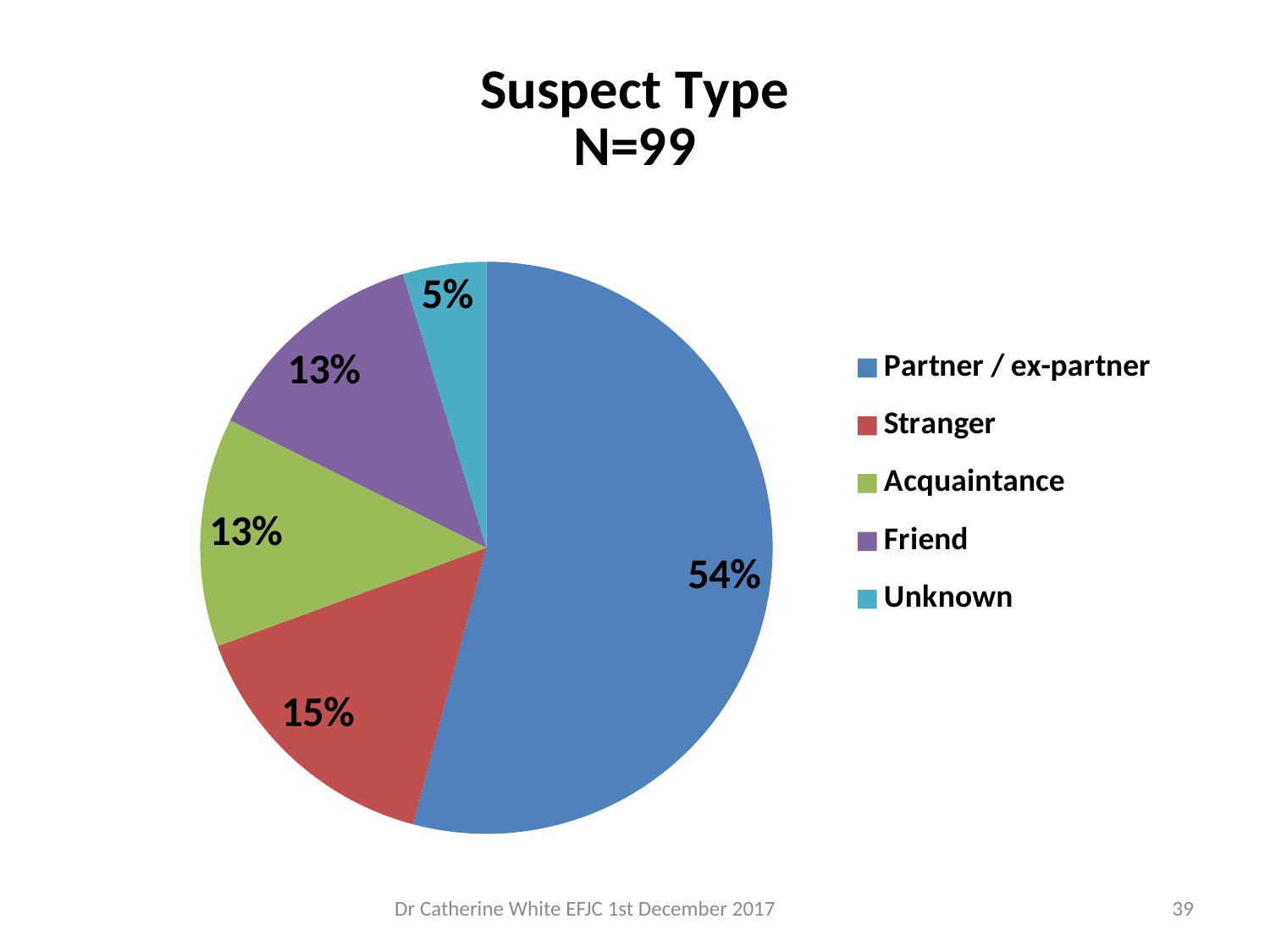
What is the title of the chart? Suspect Type N=99 What type of chart is shown on the slide? pie chart What share of the pie does Unknown represent? 5% Which suspect type has the smallest share of the pie? Unknown Which is larger, the share for Stranger or the share for Acquaintance? Stranger How many categories does the pie chart show? 5 What colour is the Acquaintance slice? green What share of the pie does Stranger represent? 15% What share of the pie does Friend represent? 13% What is the difference in percentage points between the Partner / ex-partner share and the Stranger share? 39 Which suspect type has the largest share of the pie? Partner / ex-partner